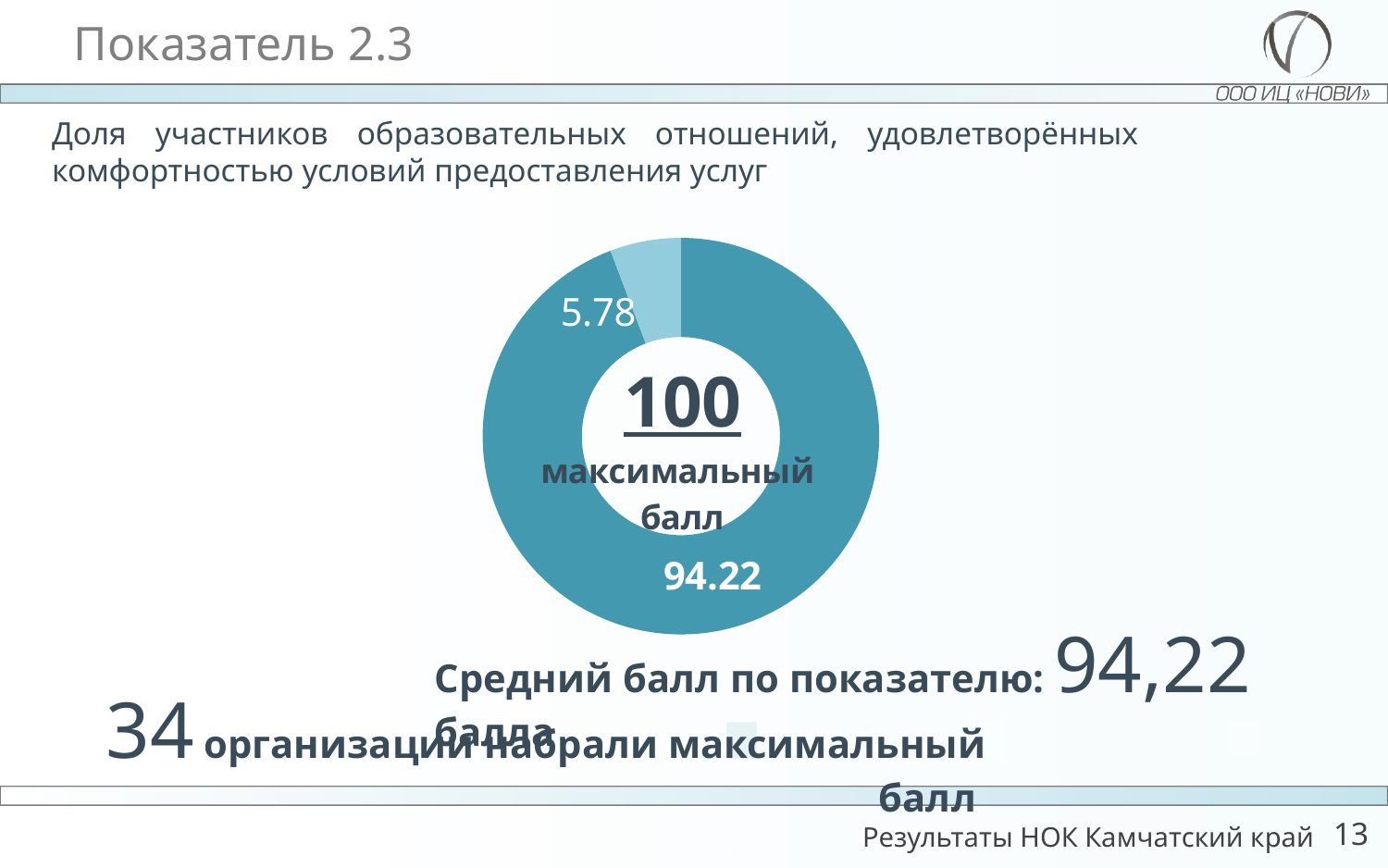
What is the largest value shown on the donut chart? 94.22 What value is labelled on the large dark teal slice of the donut chart? 94.22 Which slice of the donut chart is larger, the dark teal one or the light teal one? The dark teal one What is the difference between the two slice values on the donut chart (94.22 and 5.78)? 88.44 What kind of chart is shown on the slide? Donut (pie) chart What value is labelled on the small light teal slice of the donut chart? 5.78 What number is printed in the centre of the donut chart? 100 What text appears below the number 100 in the centre of the donut chart? максимальный балл How many slices does the donut chart have? 2 What share of the whole donut does the dark teal slice (94.22) represent? 94.22% What is the smallest value shown on the donut chart? 5.78 What is the total of the two slice values on the donut chart? 100